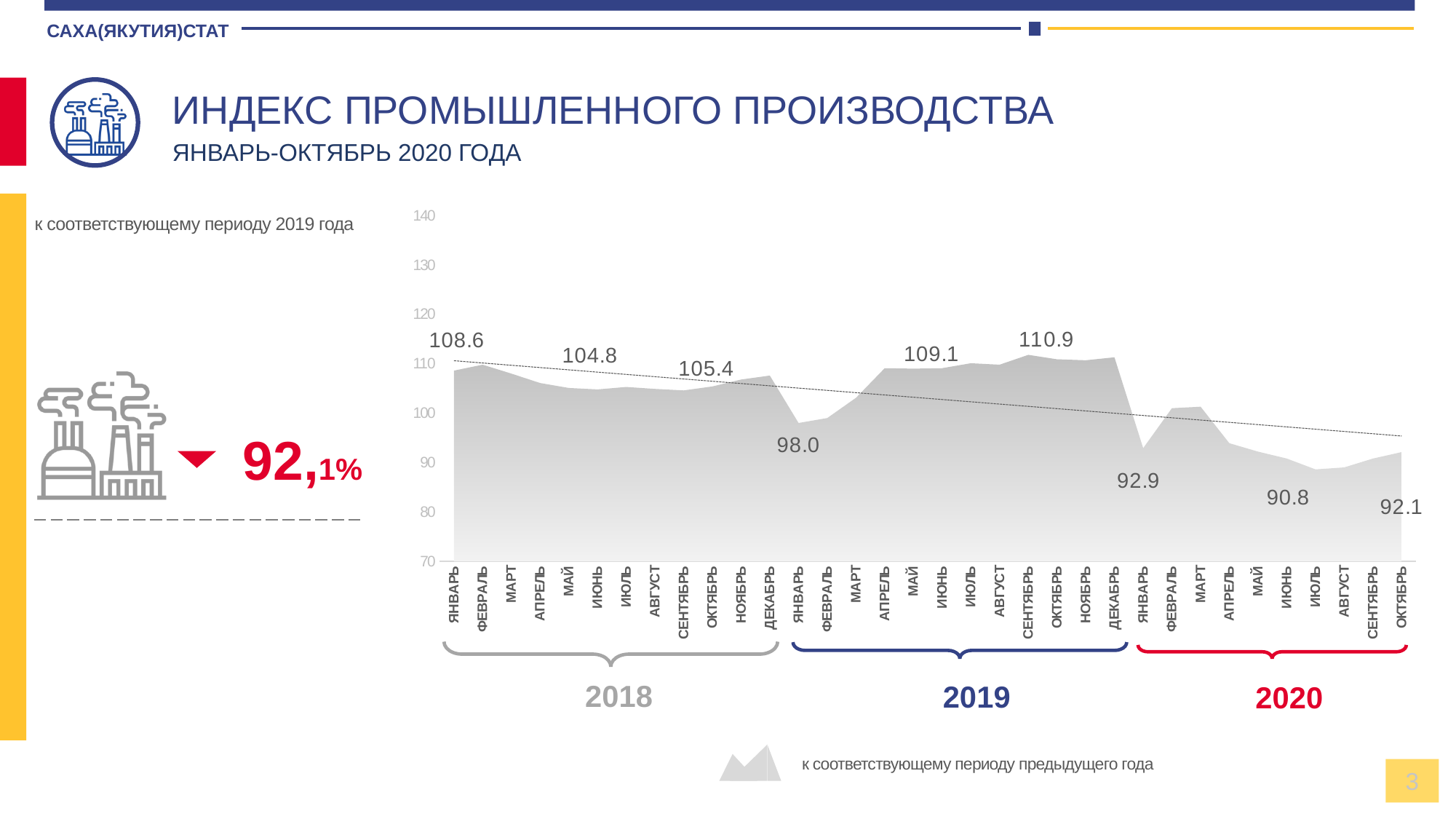
Is the value for December 2019 greater or less than 100? greater Which is larger, the value for January 2018 or the value for January 2020? January 2018 What kind of chart is used to show the industrial production index? area chart How many months of 2020 are plotted on the chart? 10 What is the lowest data label shown on the chart? 90.8 What is the index value labelled for January 2020? 92.9 Does the dashed trend line across the chart rise or fall from 2018 to 2020? fall What is the highest data label shown on the chart? 110.9 What is the industrial production index value shown for January 2018? 108.6 Is the value for April 2020 greater or less than 100? less By how much does the January 2018 value (108.6) exceed the October 2020 value (92.1)? 16.5 What is the index value labelled for October 2020, the last point on the chart? 92.1